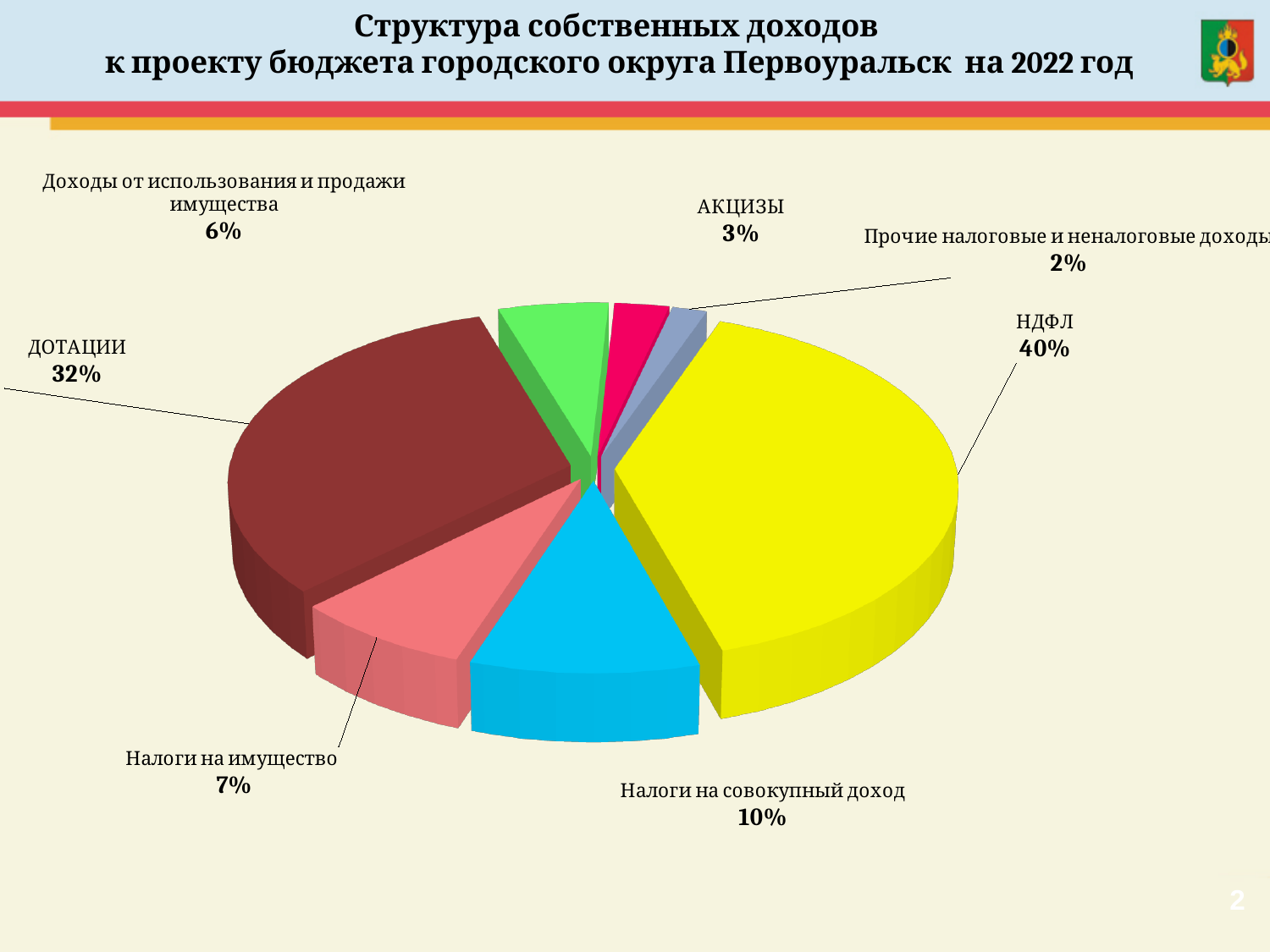
What kind of chart is shown on the slide? Pie chart What share of own revenues does НДФЛ account for? 40% What colour is the slice representing НДФЛ? Yellow What share is labelled for Налоги на совокупный доход? 10% Which category has the smallest share of the pie? Прочие налоговые и неналоговые доходы How many categories are shown in the pie chart? 7 Which is larger: Налоги на имущество or Доходы от использования и продажи имущества? Налоги на имущество Which category has the largest share of the pie? НДФЛ What is the difference in percentage points between НДФЛ and ДОТАЦИИ? 8 What is the combined share of Налоги на совокупный доход and Налоги на имущество? 17% What percentage is shown for ДОТАЦИИ? 32% What percentage is shown for АКЦИЗЫ? 3%